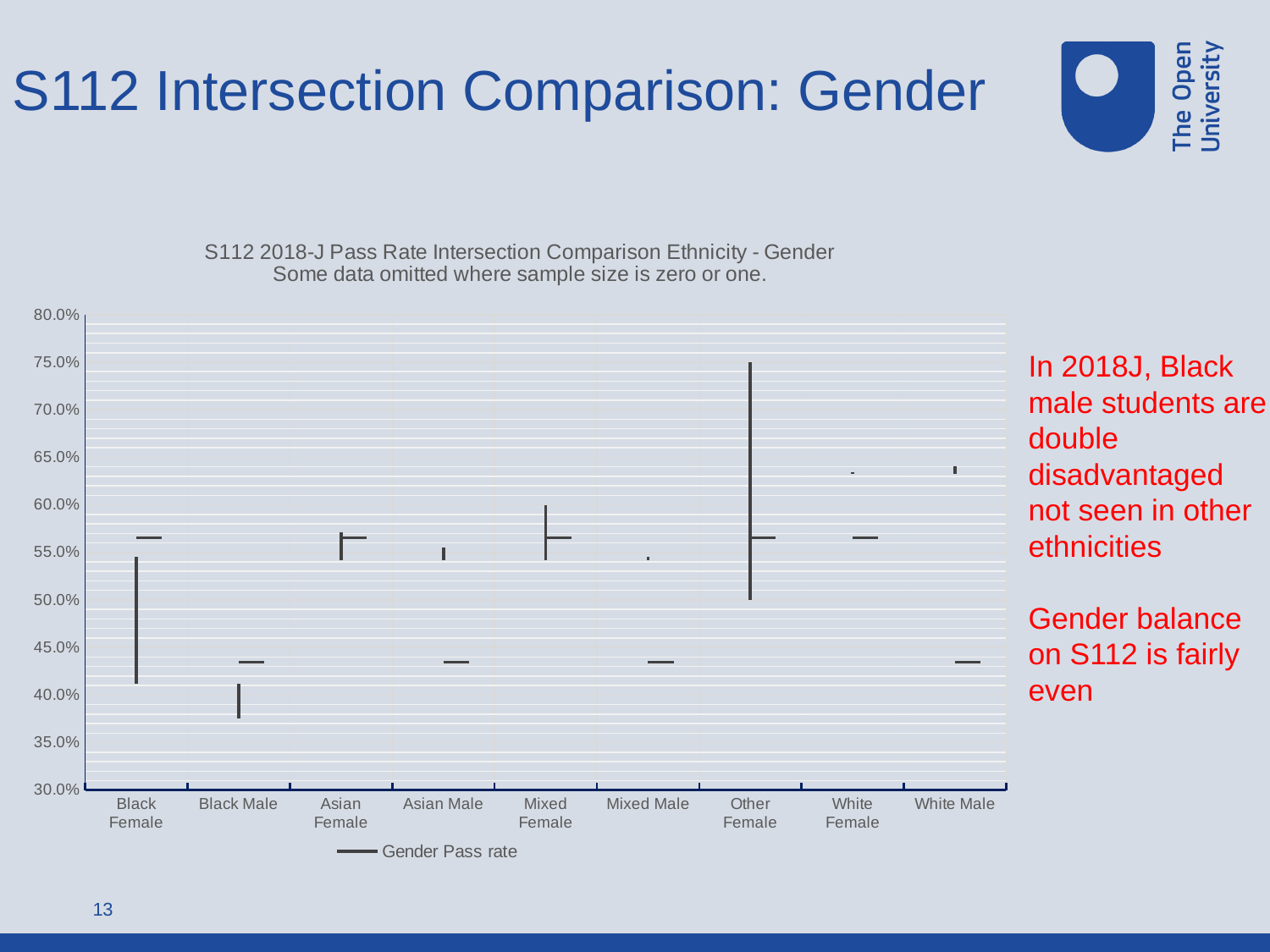
Is the top of the range for Other Female greater or less than 70%? greater Is the value for White Female greater or less than 60%? greater Is the top of the range for Mixed Female greater or less than 55%? greater What is the legend entry for the series shown? Gender Pass rate How many ethnicity-gender categories are shown on the x axis? 9 What is the title of the chart? S112 2018-J Pass Rate Intersection Comparison Ethnicity - Gender How many series does the legend list? 1 Which is higher, the pass rate range for Black Male or for White Male? White Male Which category's range reaches the highest pass rate on the chart? Other Female Which category has the lowest pass rate range on the chart? Black Male